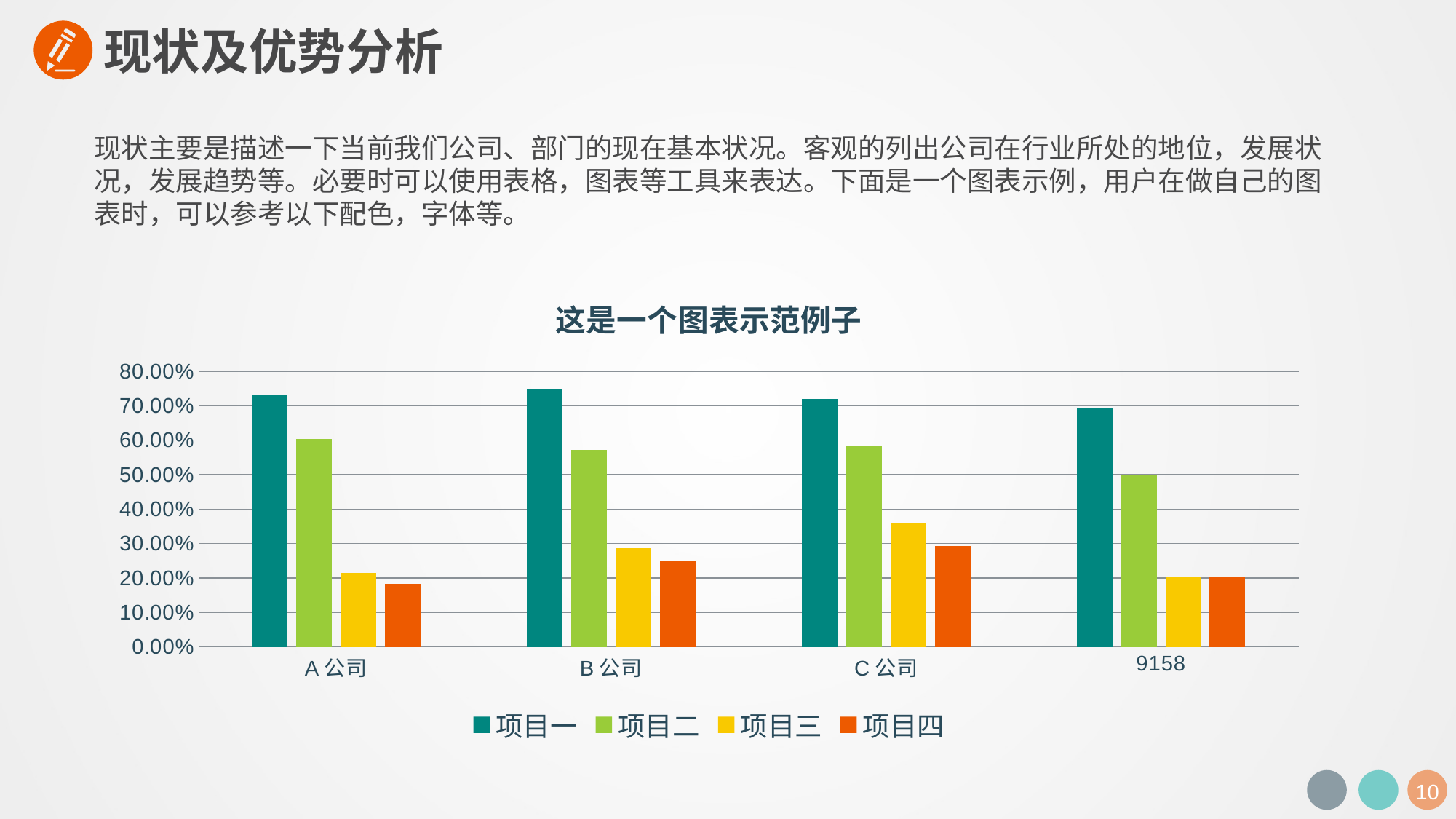
What kind of chart is shown on the slide? bar chart What is the title of the chart? 这是一个图表示范例子 Is the value of 项目三 for C 公司 greater or less than 30.00%? greater How many series does the chart legend list? 4 How many categories are shown on the x axis of the chart? 4 Which category has the lowest value for 项目一? 9158 Is the value of 项目四 for A 公司 greater or less than 20.00%? less For A 公司, which is larger, 项目二 or 项目三? 项目二 Is the value of 项目一 for A 公司 greater or less than 70.00%? greater Which series is shown in orange in the chart legend? 项目四 Which category has the highest value for 项目三? C 公司